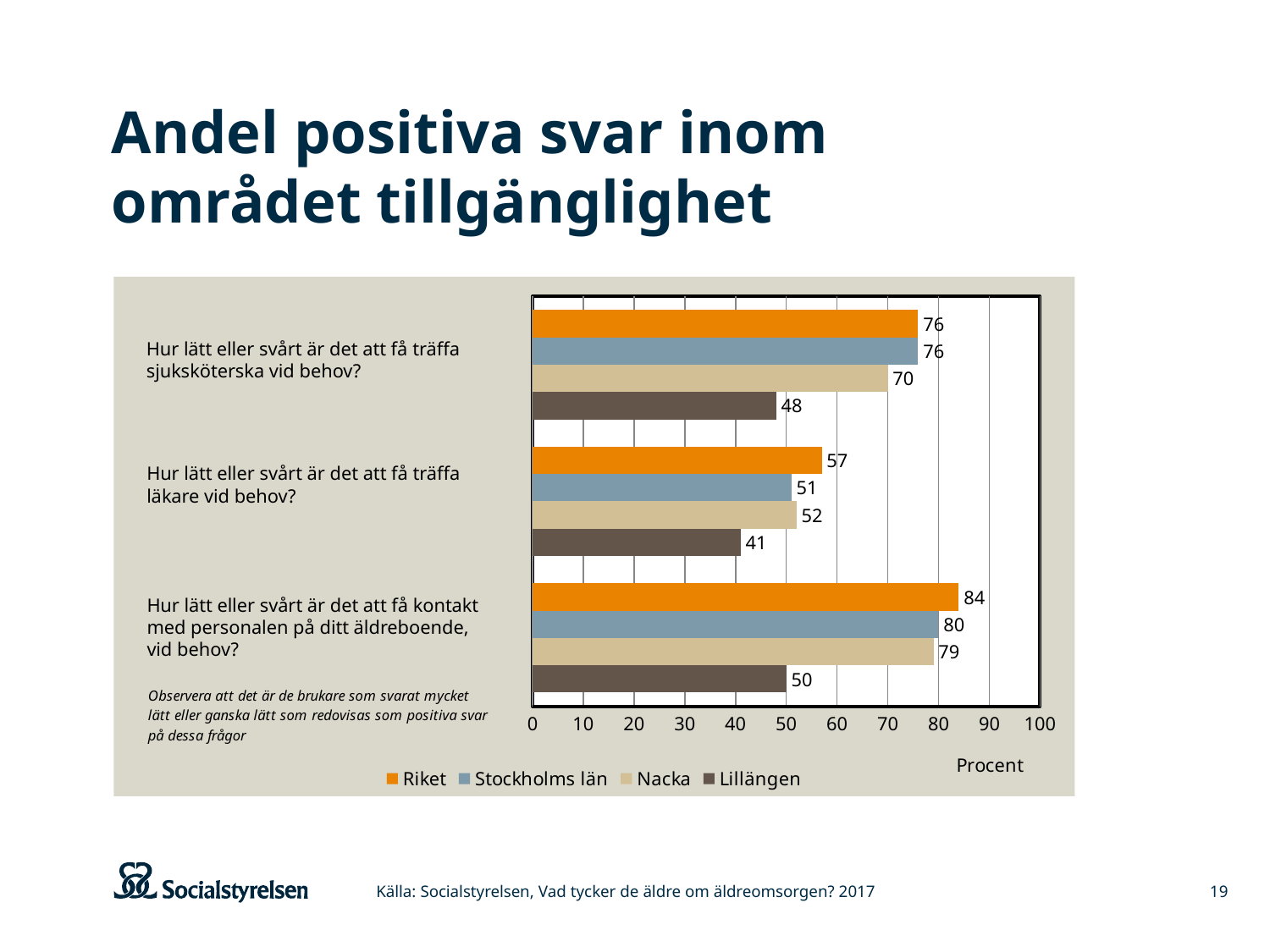
What is the label of the horizontal axis? Procent What is the value for Stockholms län on the question "Hur lätt eller svårt är det att få träffa sjuksköterska vid behov?"? 76 How many questions (categories) are shown on the chart? 3 What is the value for Nacka on the question "Hur lätt eller svårt är det att få träffa läkare vid behov?"? 52 What is the value for Riket on the question "Hur lätt eller svårt är det att få kontakt med personalen på ditt äldreboende, vid behov?"? 84 How many series does the legend list? 4 Which is larger for Lillängen: the value for "Hur lätt eller svårt är det att få träffa sjuksköterska vid behov?" or for "Hur lätt eller svårt är det att få träffa läkare vid behov?"? Hur lätt eller svårt är det att få träffa sjuksköterska vid behov? Which series has the lowest value on the question "Hur lätt eller svårt är det att få träffa läkare vid behov?"? Lillängen What kind of chart is shown on the slide? Bar chart Which series has the highest value on the question "Hur lätt eller svårt är det att få kontakt med personalen på ditt äldreboende, vid behov?"? Riket What is the value for Lillängen on the question "Hur lätt eller svårt är det att få träffa sjuksköterska vid behov?"? 48 What is the difference between Riket and Lillängen on the question "Hur lätt eller svårt är det att få kontakt med personalen på ditt äldreboende, vid behov?"? 34